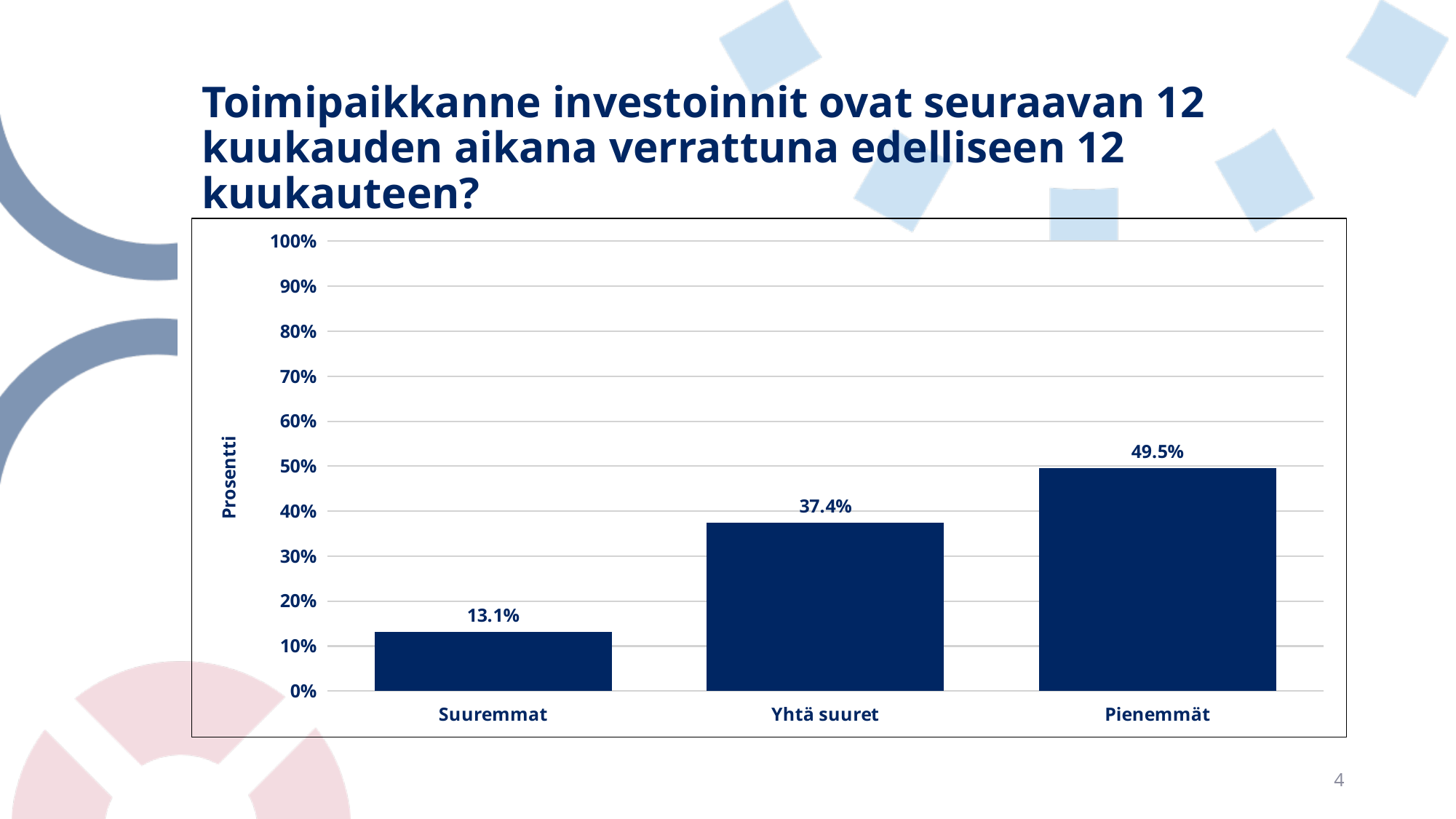
What kind of chart is shown on the slide? bar chart What is the value for Pienemmät? 49.5% Is the value for Pienemmät greater or less than 50%? less Which is larger, the value for Suuremmat or the value for Yhtä suuret? Yhtä suuret What is the value for Suuremmat? 13.1% What is the label of the vertical axis? Prosentti What is the difference between the values for Pienemmät and Yhtä suuret? 12.1% What is the value for Yhtä suuret? 37.4% What is the difference between the values for Yhtä suuret and Suuremmat? 24.3% Which category has the lowest value? Suuremmat Which category has the highest value? Pienemmät How many categories are shown on the x axis? 3